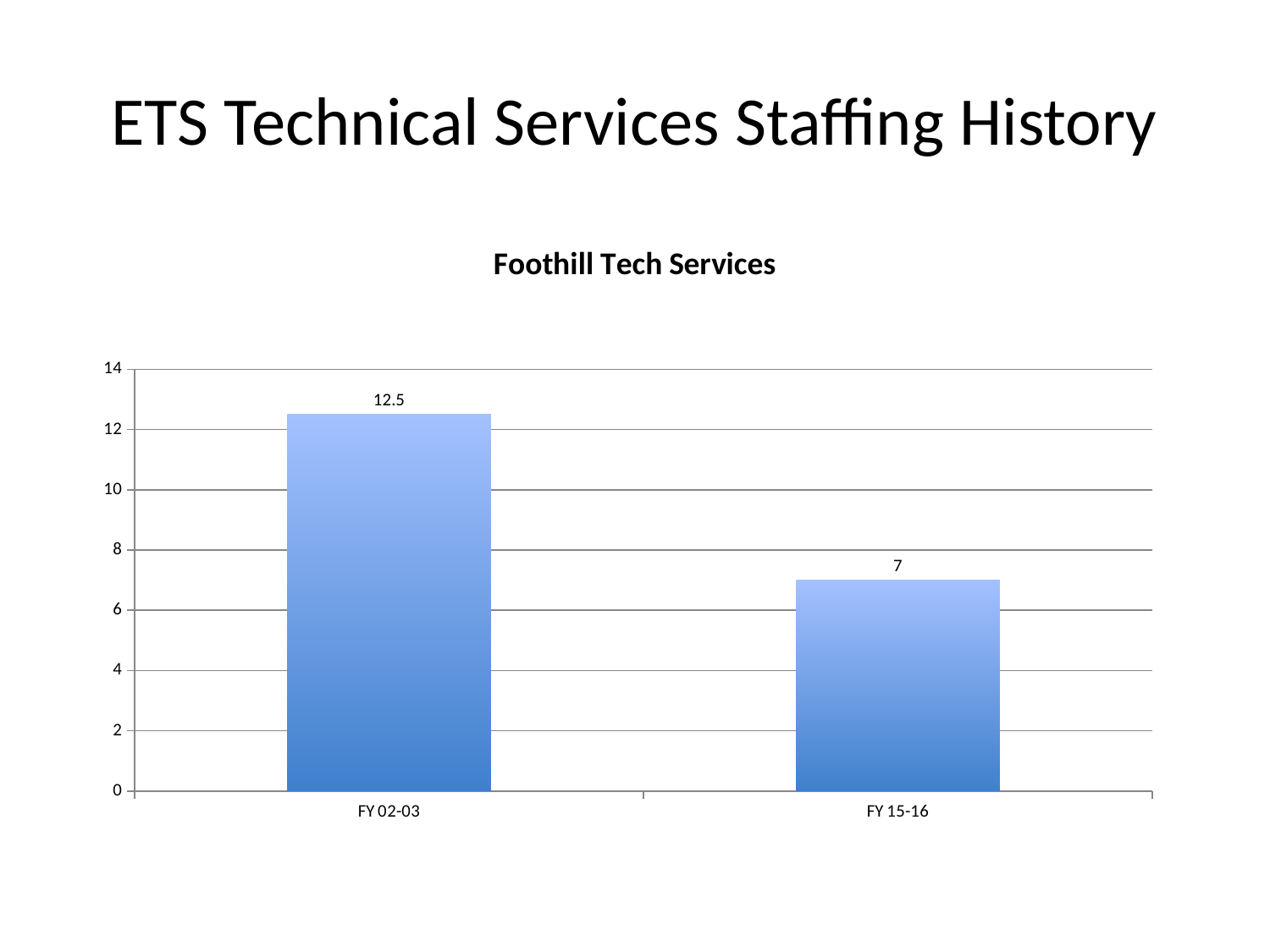
What is the title of the chart? Foothill Tech Services Is the value for FY 02-03 greater or less than 12? greater Is the value for FY 15-16 greater or less than 8? less Which is larger, the value for FY 02-03 or the value for FY 15-16? FY 02-03 What kind of chart is shown on the slide? bar chart Do the values rise or fall from FY 02-03 to FY 15-16? fall What is the value for FY 02-03? 12.5 What is the difference between the values for FY 02-03 and FY 15-16? 5.5 Which category has the highest value? FY 02-03 Which category has the lowest value? FY 15-16 What is the value for FY 15-16? 7 How many categories are shown on the x axis? 2